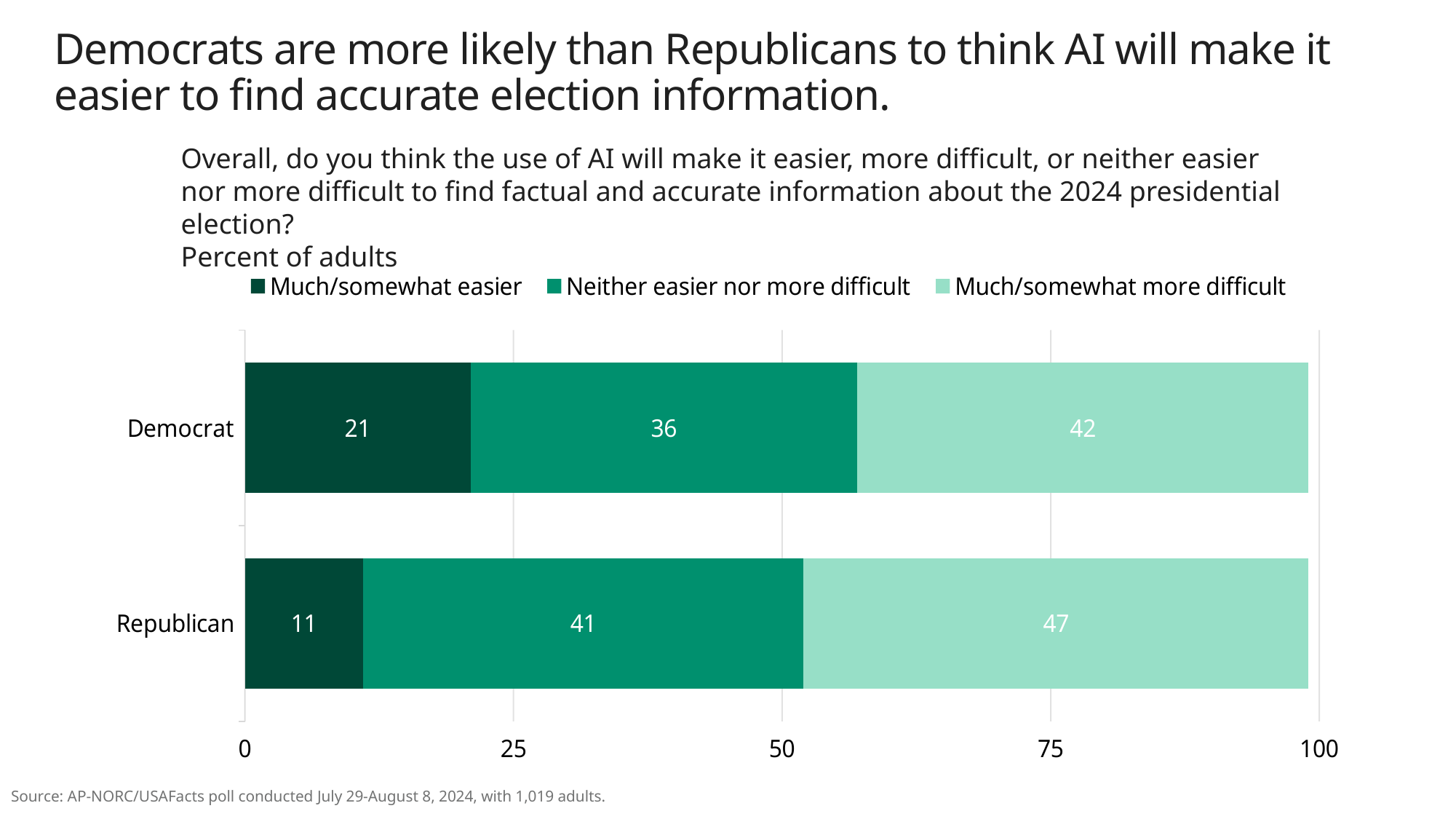
What is the difference between the Republican and Democrat shares saying AI will make it much/somewhat more difficult? 5 What percent of Republicans say AI will make it much/somewhat more difficult to find accurate election information? 47 What is the total of the three segments in the Democrat bar? 99 What is the difference between the Democrat and Republican shares saying AI will make it much/somewhat easier? 10 Which group has the higher share saying AI will make it much/somewhat easier, Democrats or Republicans? Democrat What percent of Republicans say AI will make it neither easier nor more difficult? 41 What is the total of the three segments in the Republican bar? 99 What percent of Democrats say AI will make it neither easier nor more difficult? 36 How many categories (groups) are shown on the chart? 2 What percent of Democrats say AI will make it much/somewhat easier to find accurate election information? 21 What kind of chart is shown on the slide? Stacked bar chart How many series does the legend list? 3